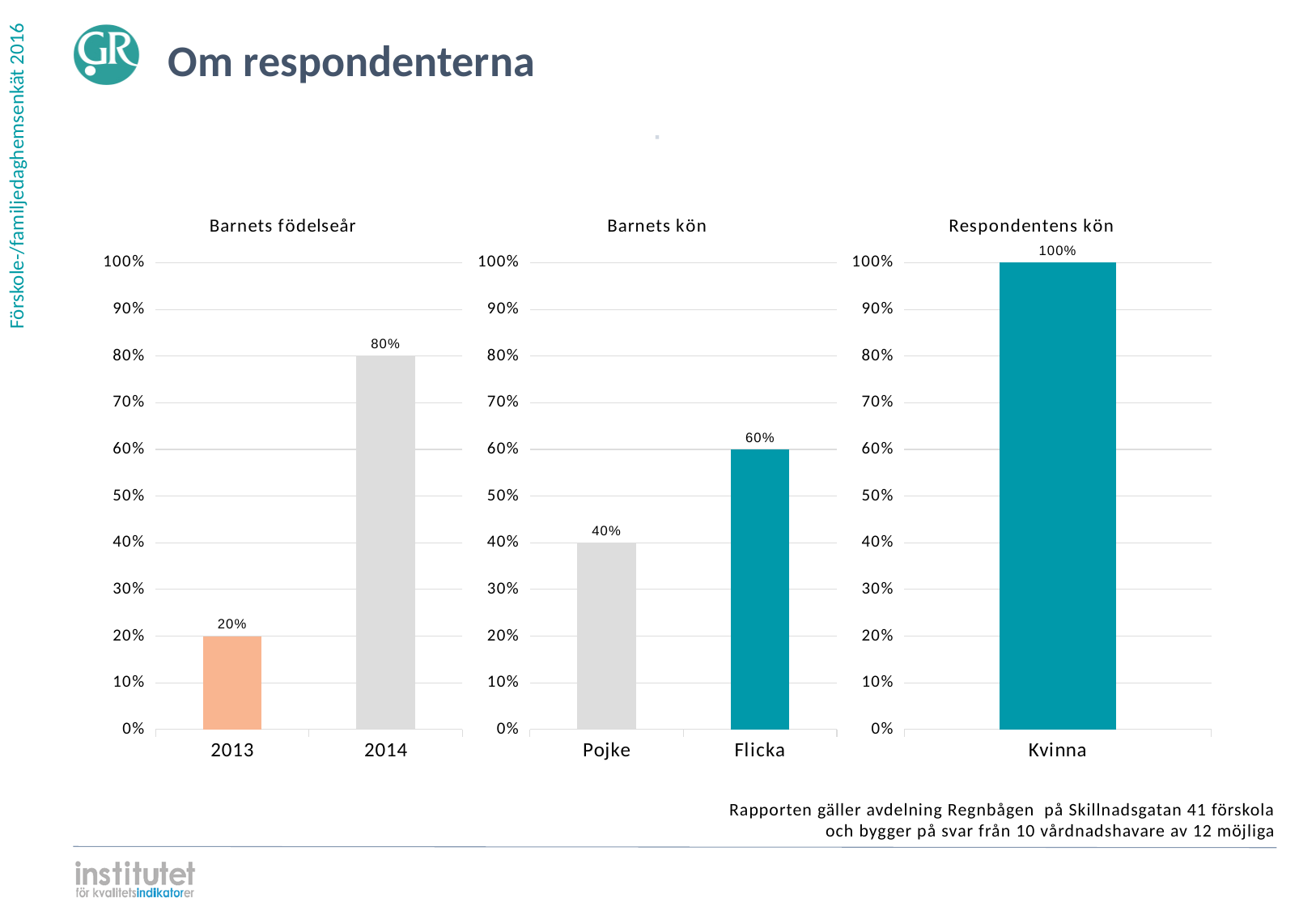
In the 'Barnets födelseår' chart, what is the value for 2014? 80% In the 'Barnets kön' chart, which category has the lowest value? Pojke In the 'Barnets födelseår' chart, which category has the highest value? 2014 In the 'Barnets kön' chart, what is the value for Pojke? 40% What kind of chart is the 'Barnets kön' chart? Bar chart How many categories are shown in the 'Respondentens kön' chart? 1 In the 'Barnets kön' chart, what is the value for Flicka? 60% In the 'Barnets kön' chart, what is the difference between the values for Flicka and Pojke? 20% In the 'Barnets födelseår' chart, what is the difference between the values for 2014 and 2013? 60% In the 'Barnets födelseår' chart, what is the value for 2013? 20% In the 'Barnets kön' chart, which is larger, the value for Pojke or the value for Flicka? Flicka In the 'Respondentens kön' chart, what is the value for Kvinna? 100%